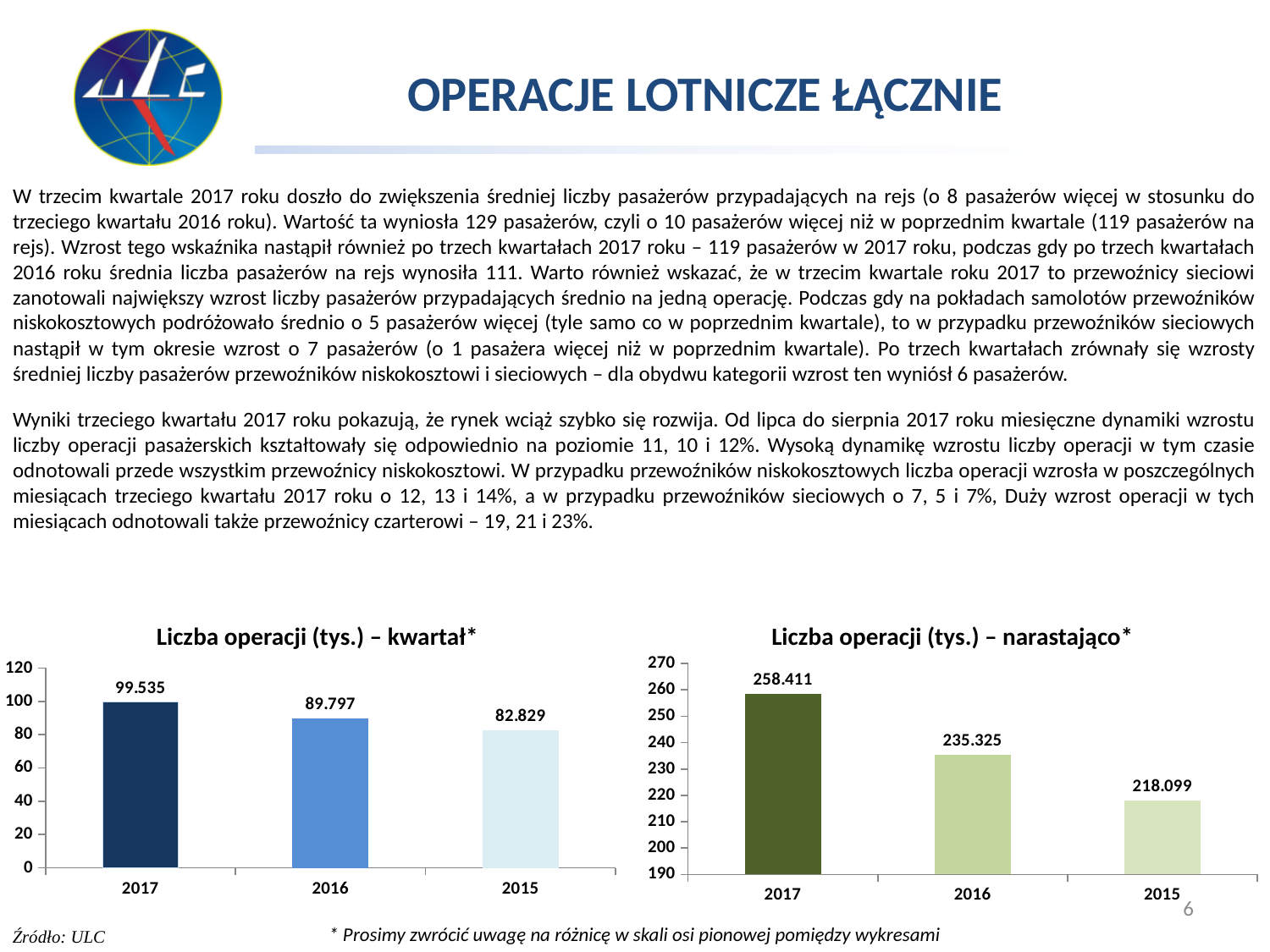
What type of chart is 'Liczba operacji (tys.) – narastająco*'? Bar chart In the chart 'Liczba operacji (tys.) – kwartał*', what is the value for 2017? 99.535 In the chart 'Liczba operacji (tys.) – narastająco*', what is the value for 2017? 258.411 In the chart 'Liczba operacji (tys.) – kwartał*', what is the value for 2015? 82.829 In the chart 'Liczba operacji (tys.) – narastająco*', what is the difference between the values for 2017 and 2015? 40.312 In the chart 'Liczba operacji (tys.) – kwartał*', do the values rise or fall from left to right along the x axis? Fall In the chart 'Liczba operacji (tys.) – narastająco*', which year has the lowest value? 2015 In the chart 'Liczba operacji (tys.) – narastająco*', what is the value for 2016? 235.325 How many bars are shown in the chart 'Liczba operacji (tys.) – kwartał*'? 3 In the chart 'Liczba operacji (tys.) – narastająco*', which is larger: the value for 2016 or the value for 2015? 2016 In the chart 'Liczba operacji (tys.) – kwartał*', what is the difference between the values for 2017 and 2016? 9.738 In the chart 'Liczba operacji (tys.) – kwartał*', which year has the highest value? 2017